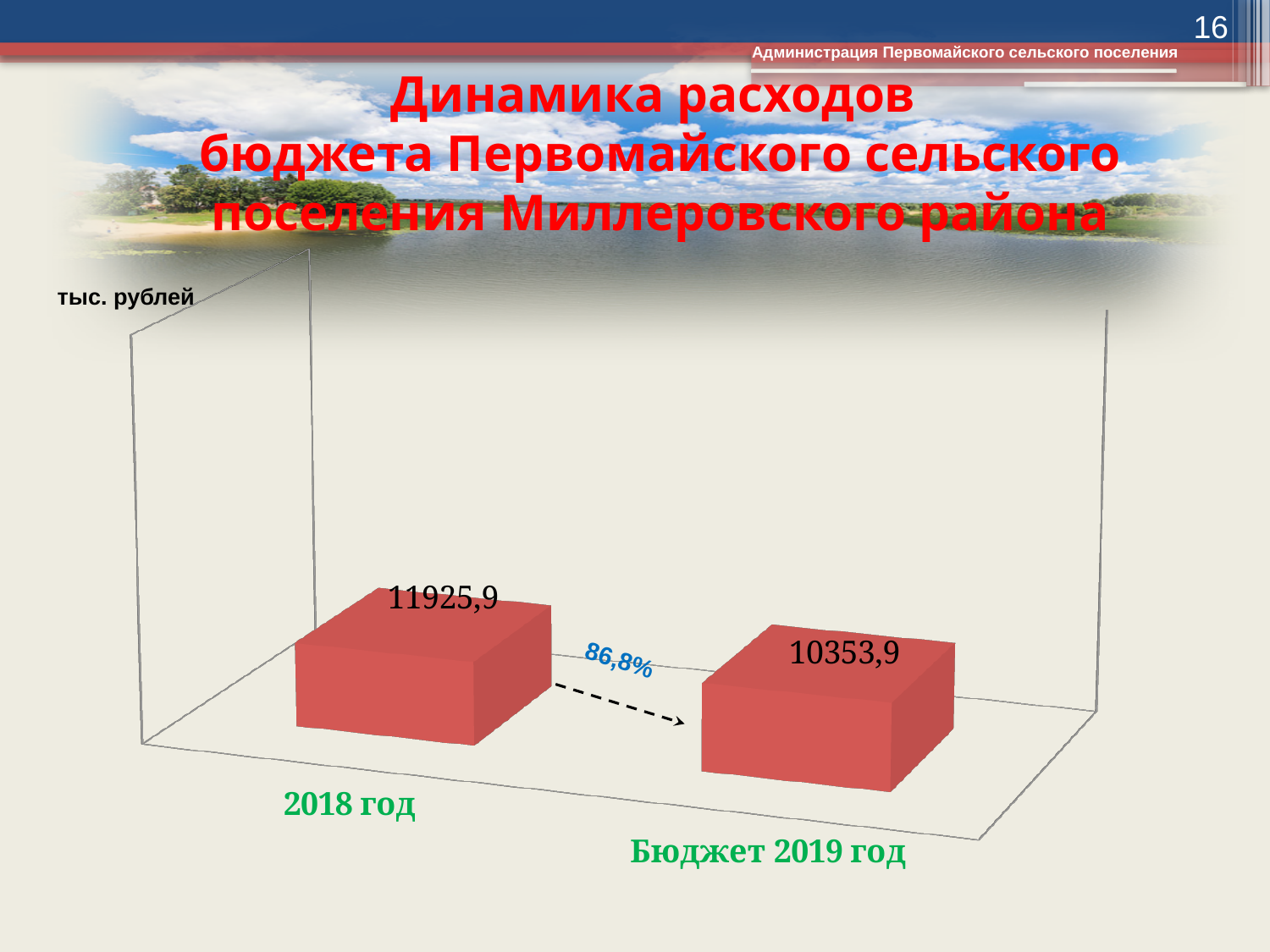
How many categories are plotted in the chart? 2 What is the difference between the value for 2018 год and the value for Бюджет 2019 год? 1572,0 What is the value shown for Бюджет 2019 год? 10353,9 Do the values rise or fall from 2018 год to Бюджет 2019 год? Fall Which category has the lowest value? Бюджет 2019 год What is the value shown for 2018 год? 11925,9 Which is larger, the value for 2018 год or the value for Бюджет 2019 год? 2018 год Which category has the highest value? 2018 год What unit of measurement is indicated on the chart? тыс. рублей What kind of chart is shown on the slide? Bar chart What percentage is written on the arrow between the two bars? 86,8%